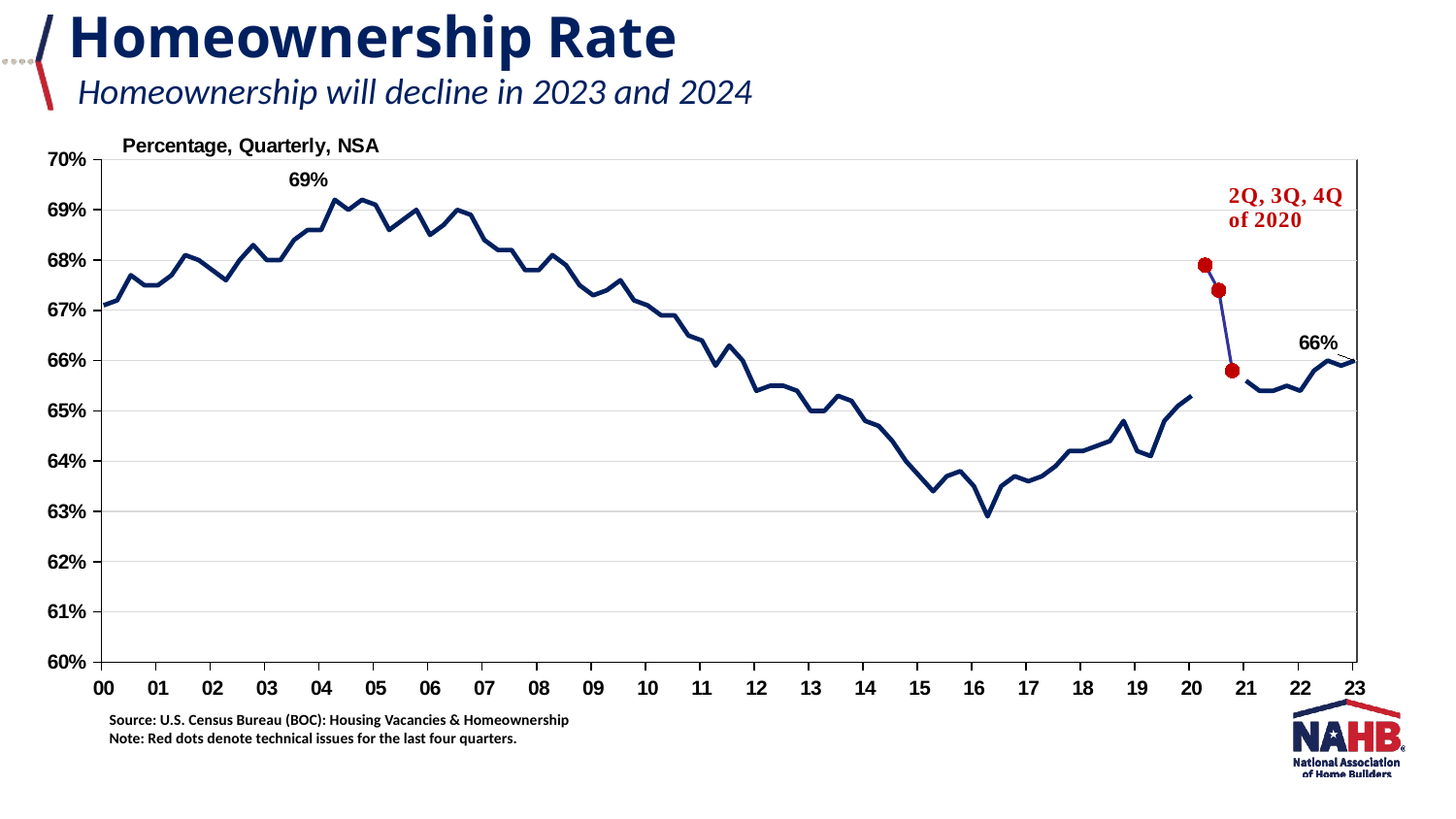
What is the labeled peak value of the homeownership rate reached around 2004? 69% Is the homeownership rate in 2019 greater or less than 66%? less What kind of chart is shown on the slide? Line chart Which year has the higher homeownership rate, 2004 or 2016? 2004 Does the homeownership rate rise or fall between 2004 and 2016? Fall Is the homeownership rate in 2010 greater or less than 66%? greater Is the homeownership rate in 2016 greater or less than 64%? less What is the subtitle printed above the chart describing the data? Percentage, Quarterly, NSA What is the difference between the labeled 2004 peak (69%) and the labeled 2023 value (66%)? 3 percentage points What is the labeled homeownership rate at the end of the series in 2023? 66% Around which year does the homeownership rate reach its lowest point? 2016 Which quarters do the red dots on the chart mark? 2Q, 3Q, 4Q of 2020